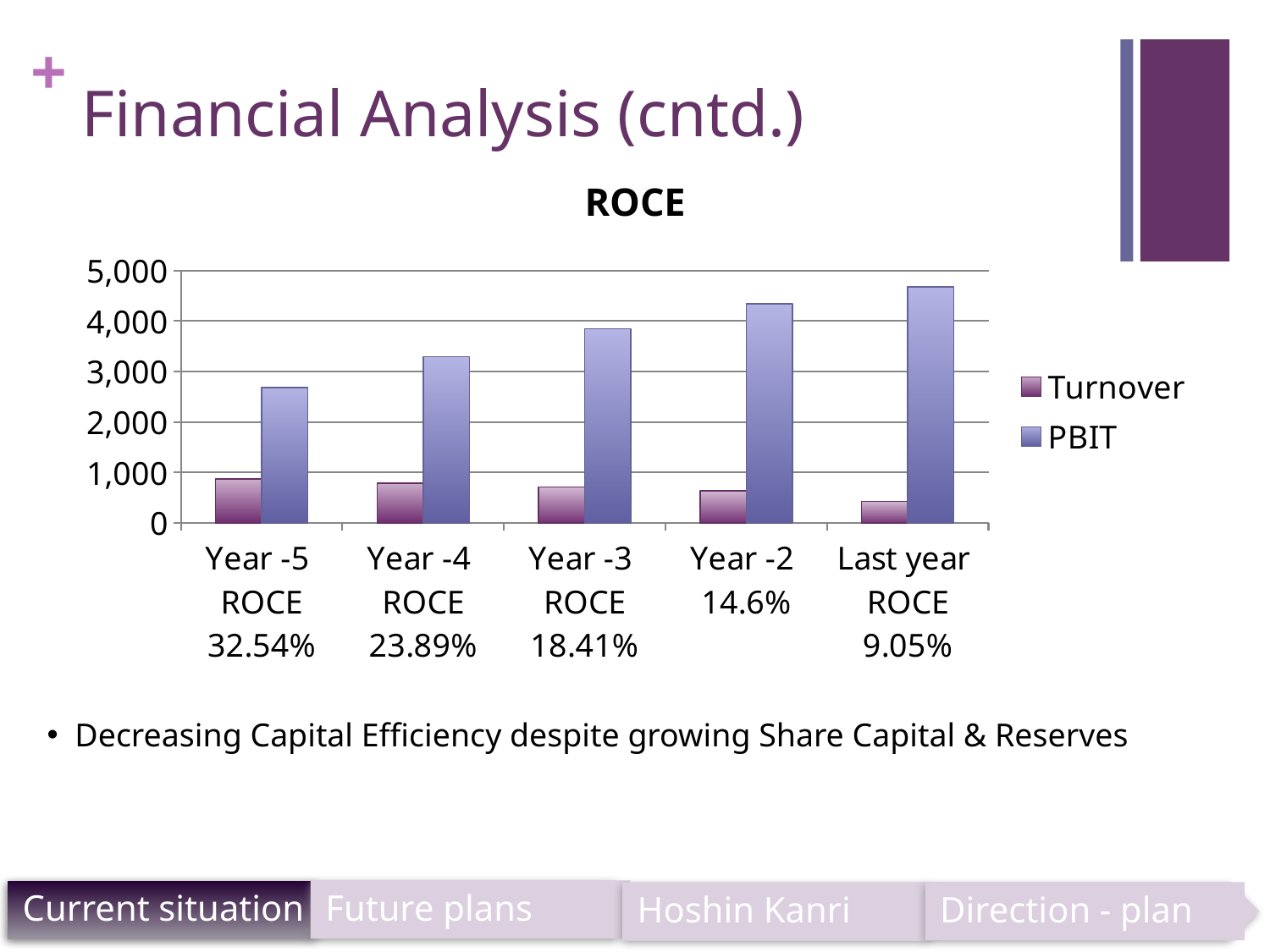
Which year has the highest Turnover bar? Year -5 Which year has the lowest PBIT bar? Year -5 Is the PBIT value for Last year greater or less than 4,000? greater Which year has the lowest Turnover bar? Last year Do the PBIT values rise or fall from Year -5 to Last year? rise Which year has the highest PBIT bar? Last year What is the title of the chart? ROCE How many series does the legend list? 2 Is the PBIT value for Year -5 greater or less than 3,000? less What ROCE percentage is shown in the axis label for Year -4? 23.89% How many year categories are shown on the x axis? 5 What kind of chart is shown on the slide? bar chart